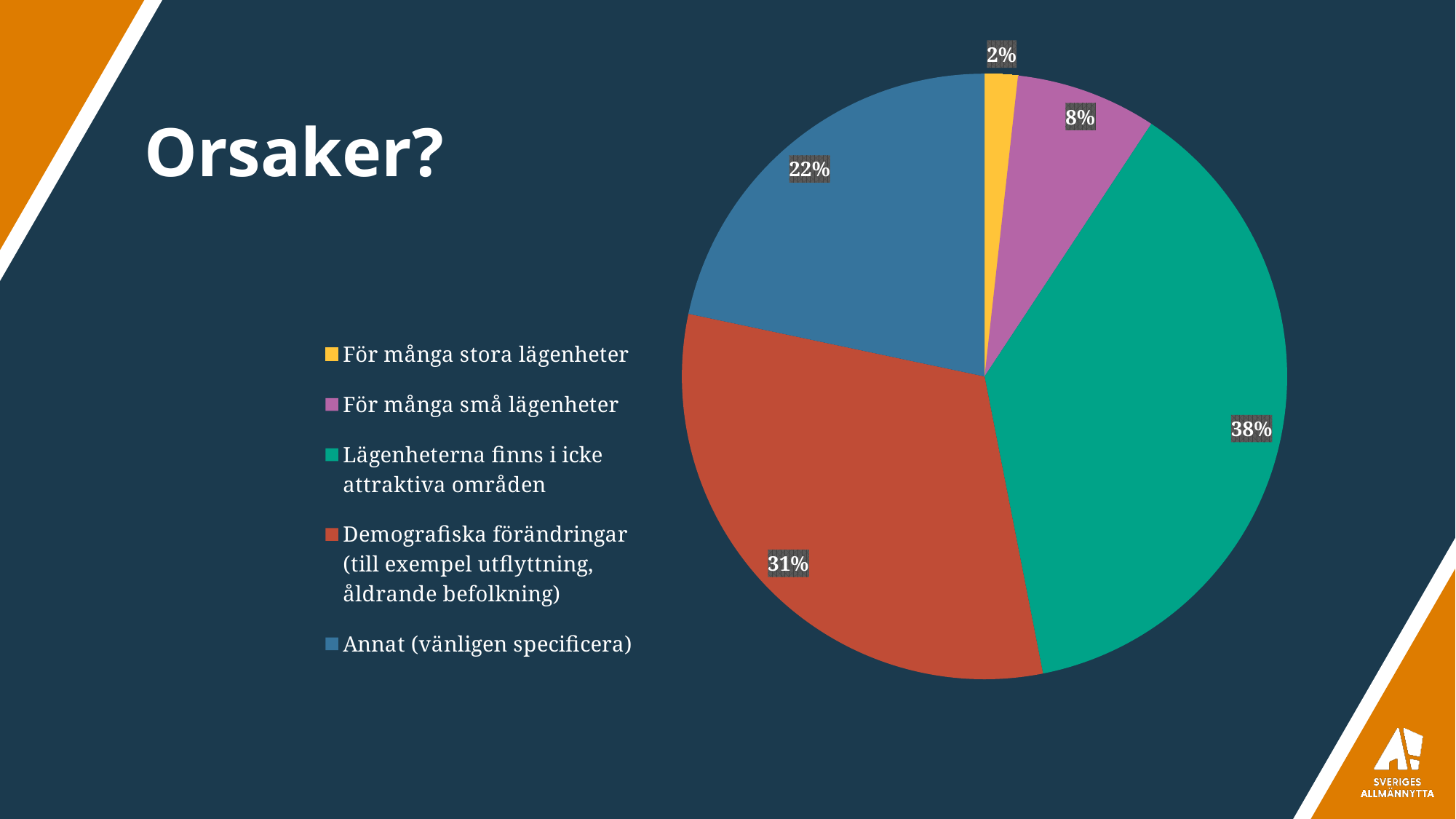
Which is larger: the slice for "Annat (vänligen specificera)" or the slice for "För många små lägenheter"? Annat (vänligen specificera) Which category has the largest slice of the pie? Lägenheterna finns i icke attraktiva områden What share of the pie does "Demografiska förändringar (till exempel utflyttning, åldrande befolkning)" have? 31% How many categories does the pie chart have? 5 What is the difference in percentage points between "Lägenheterna finns i icke attraktiva områden" and "Demografiska förändringar"? 7 percentage points What type of chart is shown on the slide? pie chart What share of the pie does "För många små lägenheter" have? 8% Which category has the smallest slice of the pie? För många stora lägenheter What share of the pie does "Annat (vänligen specificera)" have? 22% What is the title of the slide containing the pie chart? Orsaker?